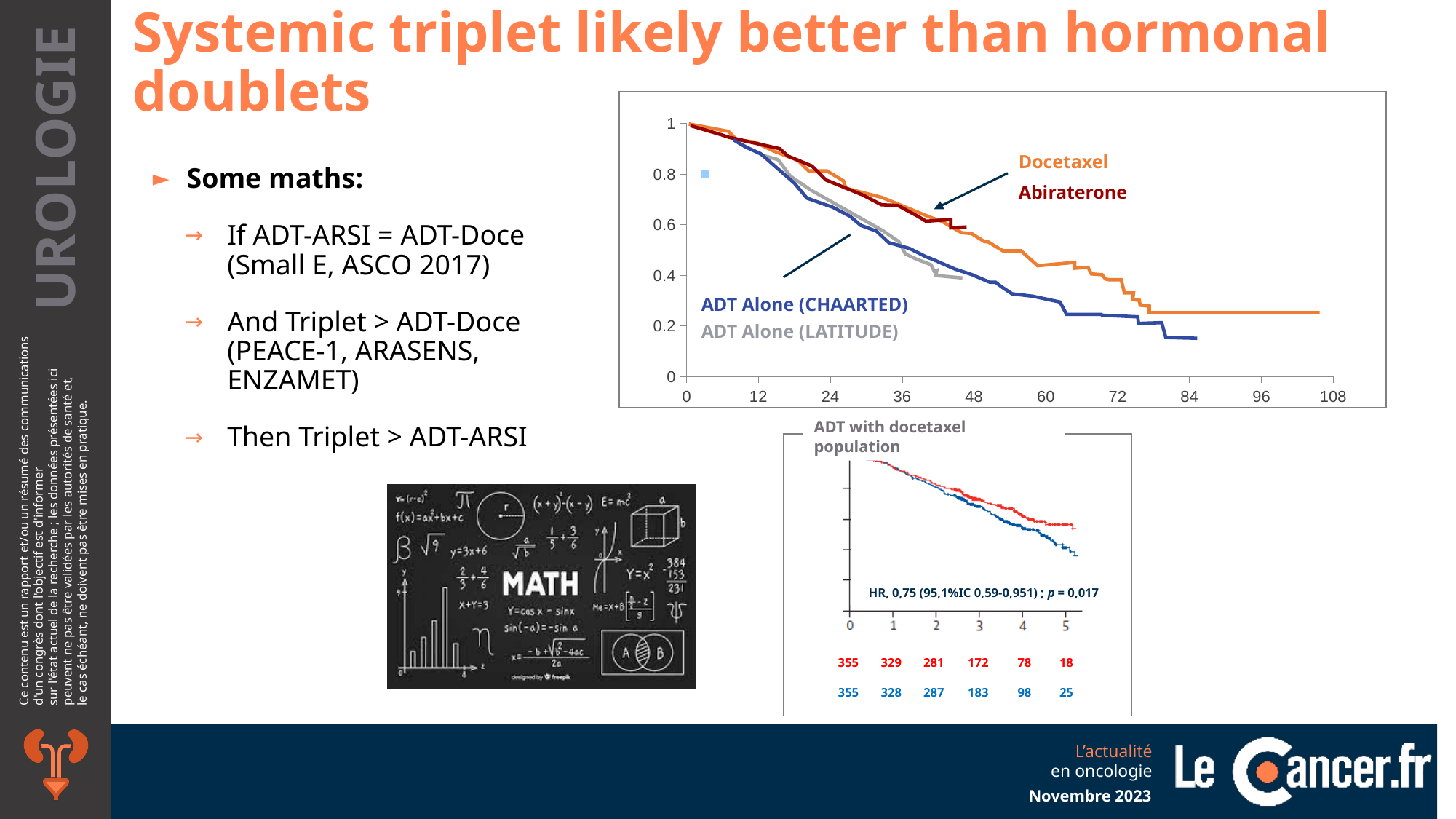
On the large line chart, is the ADT Alone (CHAARTED) value at x = 60 greater or less than 0.4? less On the small 'ADT with docetaxel population' chart, what hazard ratio (HR) is printed? 0,75 What kind of chart is the large chart in the upper right of the slide? line chart How many series are labelled on the large line chart in the upper right? 4 On the large line chart, is the ADT Alone (LATITUDE) value at x = 36 greater or less than 0.6? less On the large line chart, which series ends at the lowest value? ADT Alone (CHAARTED) On the large line chart, do the values rise or fall as the x axis increases? fall On the large line chart, is the Docetaxel value at x = 84 greater or less than 0.4? less On the large line chart, at x = 60, which is higher: Docetaxel or ADT Alone (CHAARTED)? Docetaxel On the large line chart, what is the highest tick value shown on the x axis? 108 On the small 'ADT with docetaxel population' chart, what is the red number at risk at time 3? 172